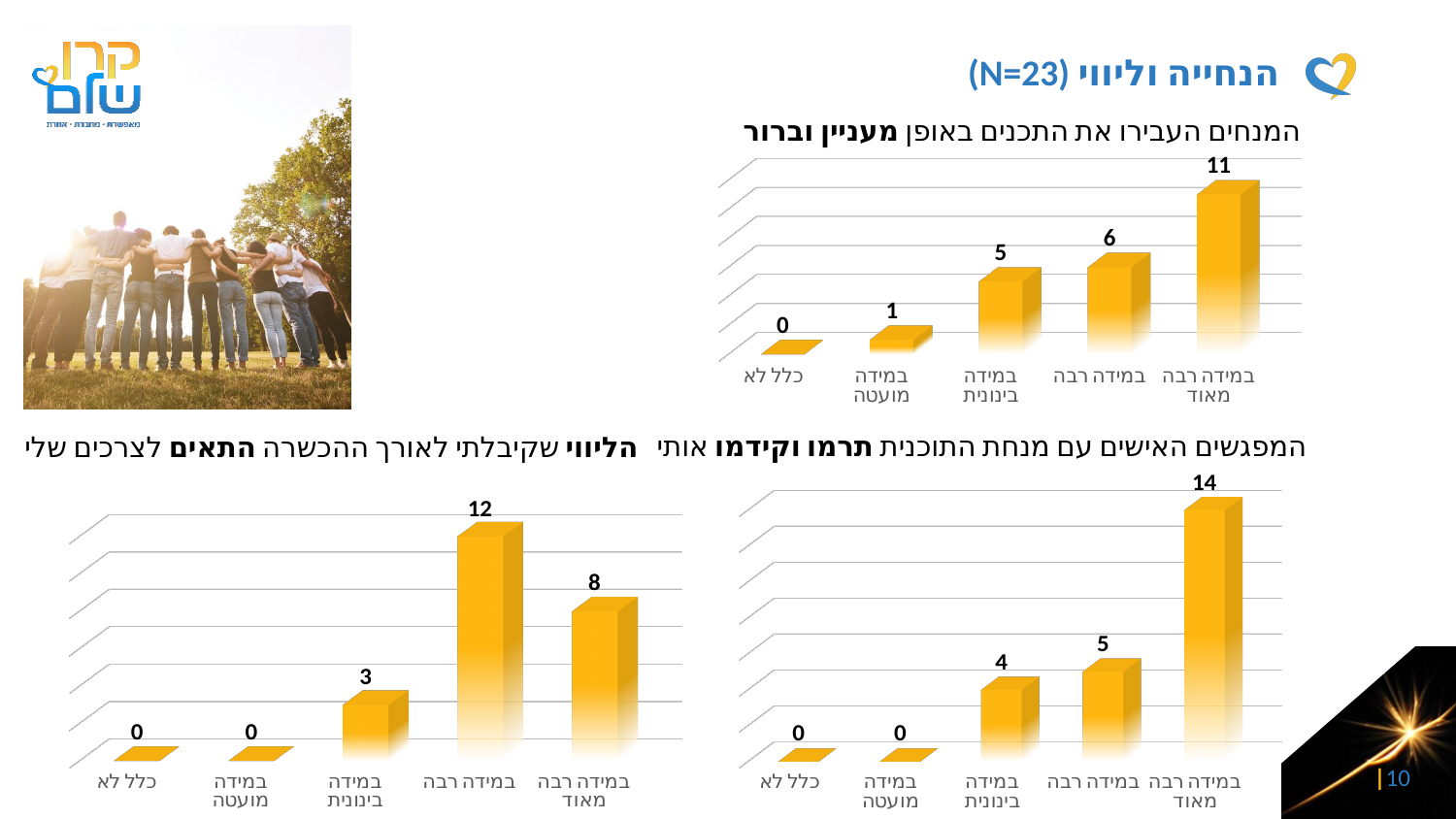
In the bottom-left chart, what is the value for במידה רבה מאוד? 8 In the top-right chart, how many categories are shown on the x axis? 5 In the top-right chart, which category has the highest value? במידה רבה מאוד In the bottom-right chart (הליווי שקיבלתי לאורך ההכשרה התאים לצרכים שלי), what is the value for במידה רבה מאוד? 14 In the bottom-right chart, which is larger: the value for במידה רבה or the value for במידה בינונית? במידה רבה In the top-right chart (המנחים העבירו את התכנים באופן מעניין וברור), what is the value for במידה רבה מאוד? 11 In the bottom-left chart, what is the difference between the values for במידה רבה and במידה רבה מאוד? 4 What type of chart is the bottom-left chart? Bar chart In the bottom-right chart, what is the value for במידה בינונית? 4 In the top-right chart, what is the value for במידה בינונית? 5 In the top-right chart, what is the difference between the values for במידה רבה מאוד and במידה רבה? 5 In the bottom-left chart (המפגשים האישים עם מנחת התוכנית תרמו וקידמו אותי), what is the value for במידה רבה? 12